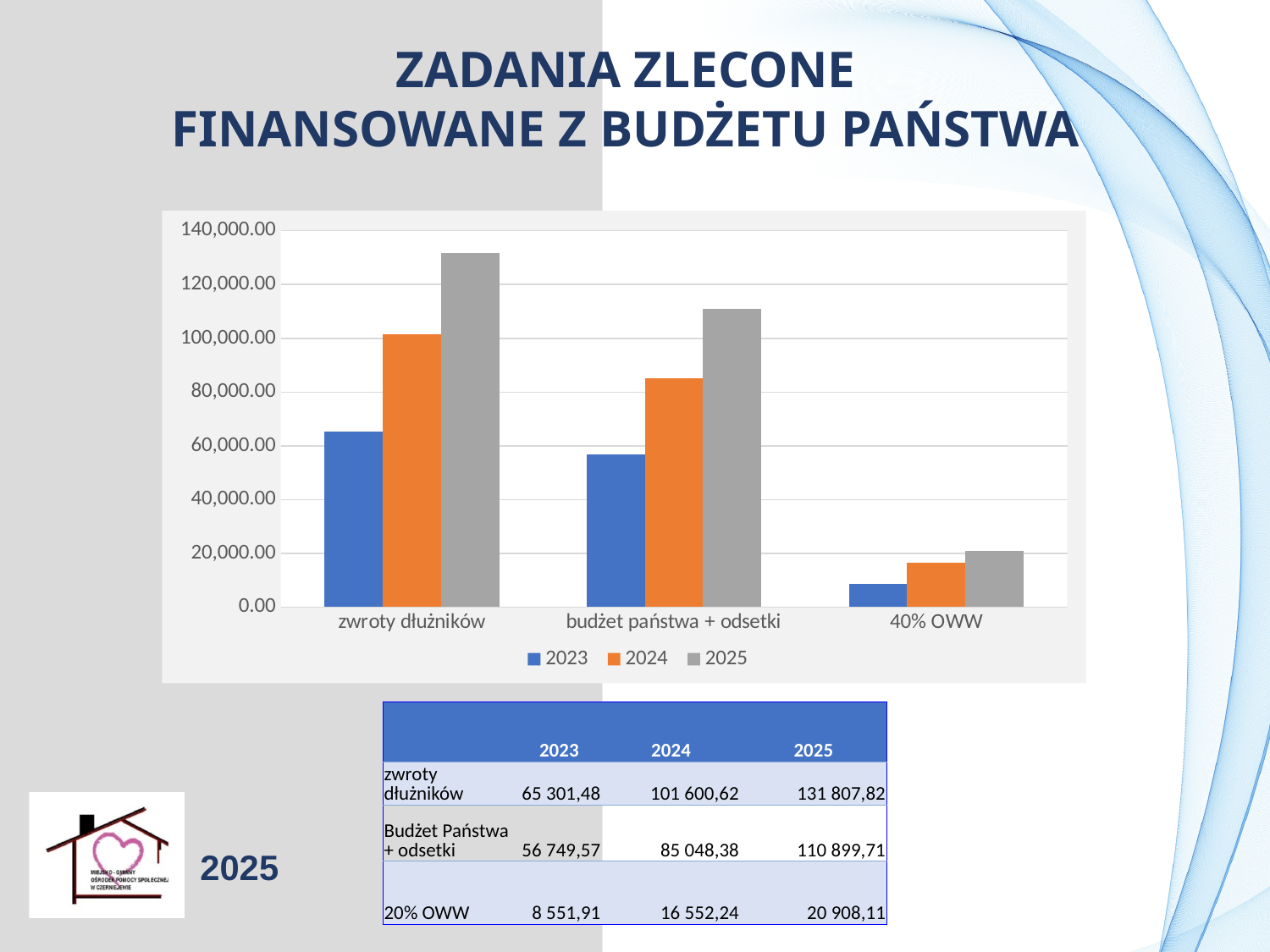
What is the 2025 value for Budżet Państwa + odsetki? 110 899,71 What colour represents the 2025 series in the chart? grey Is the 2024 value for 40% OWW greater or less than 20,000.00? less How many categories are shown on the x axis of the chart? 3 Which is larger: the 2024 value for budżet państwa + odsetki or the 2023 value for zwroty dłużników? 2024 value for budżet państwa + odsetki What is the 2024 value for zwroty dłużników? 101 600,62 Which category has the lowest values in the chart? 40% OWW How many series does the chart legend list? 3 What kind of chart is shown on the slide? bar chart Is the 2023 value for zwroty dłużników greater or less than 60,000.00? greater Which category has the tallest bar in the chart? zwroty dłużników Do the values for zwroty dłużników rise or fall from 2023 to 2025? rise